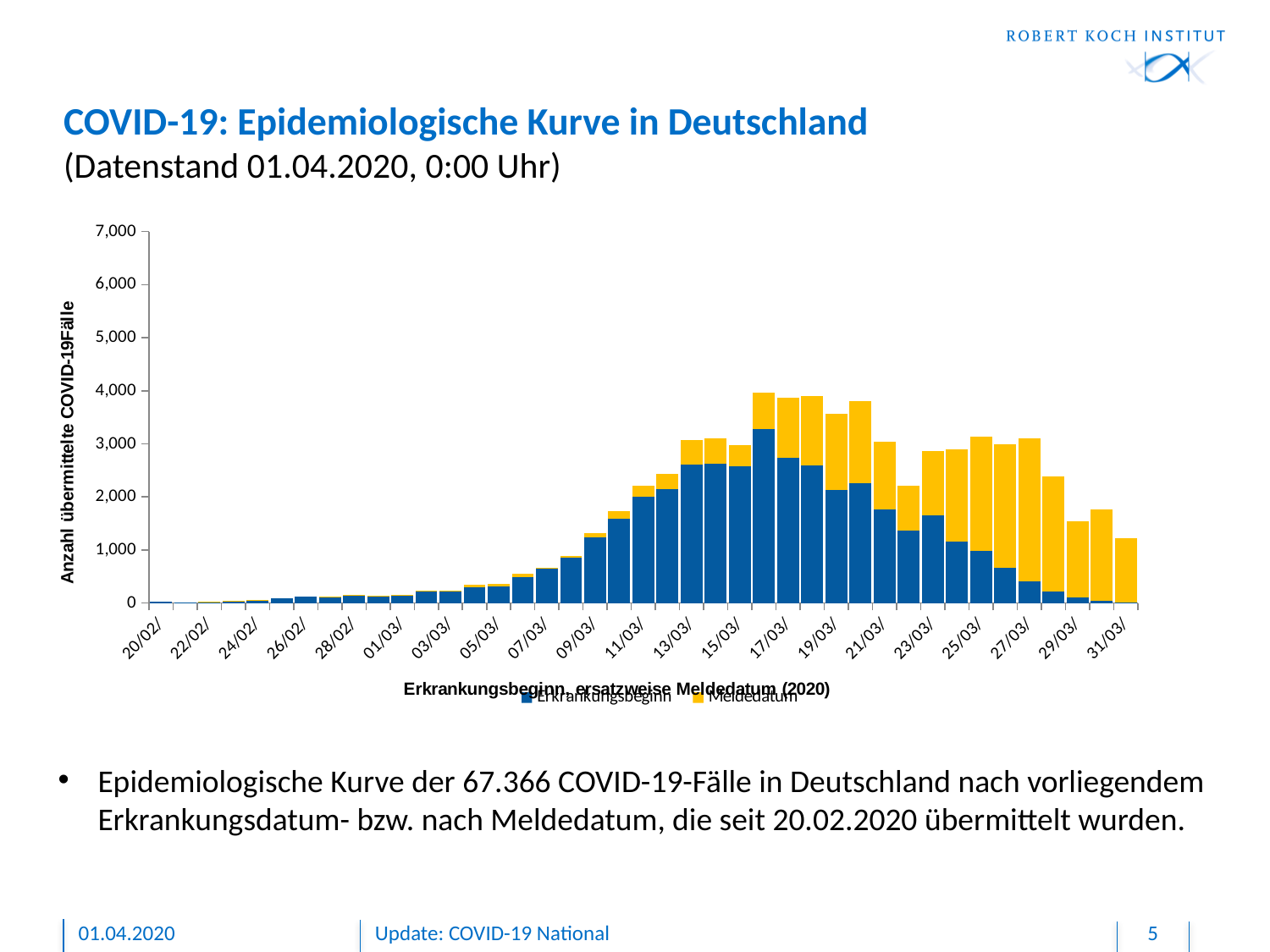
Which bar has the larger total, 17/03 or 31/03? 17/03 What kind of chart is shown on the slide? Stacked bar chart Do the bar totals generally rise or fall from 20/02 to 15/03? rise Is the total value of the bar for 31/03 greater or less than 2,000? less How many series does the chart's legend list? 2 Which bar has the larger Erkrankungsbeginn (blue) portion, 17/03 or 29/03? 17/03 Is the total value of the bar for 17/03 greater or less than 3,000? greater What is the label of the vertical axis? Anzahl übermittelte COVID-19Fälle Is the total value of the bar for 07/03 greater or less than 1,000? less What are the two series named in the legend? Erkrankungsbeginn and Meldedatum